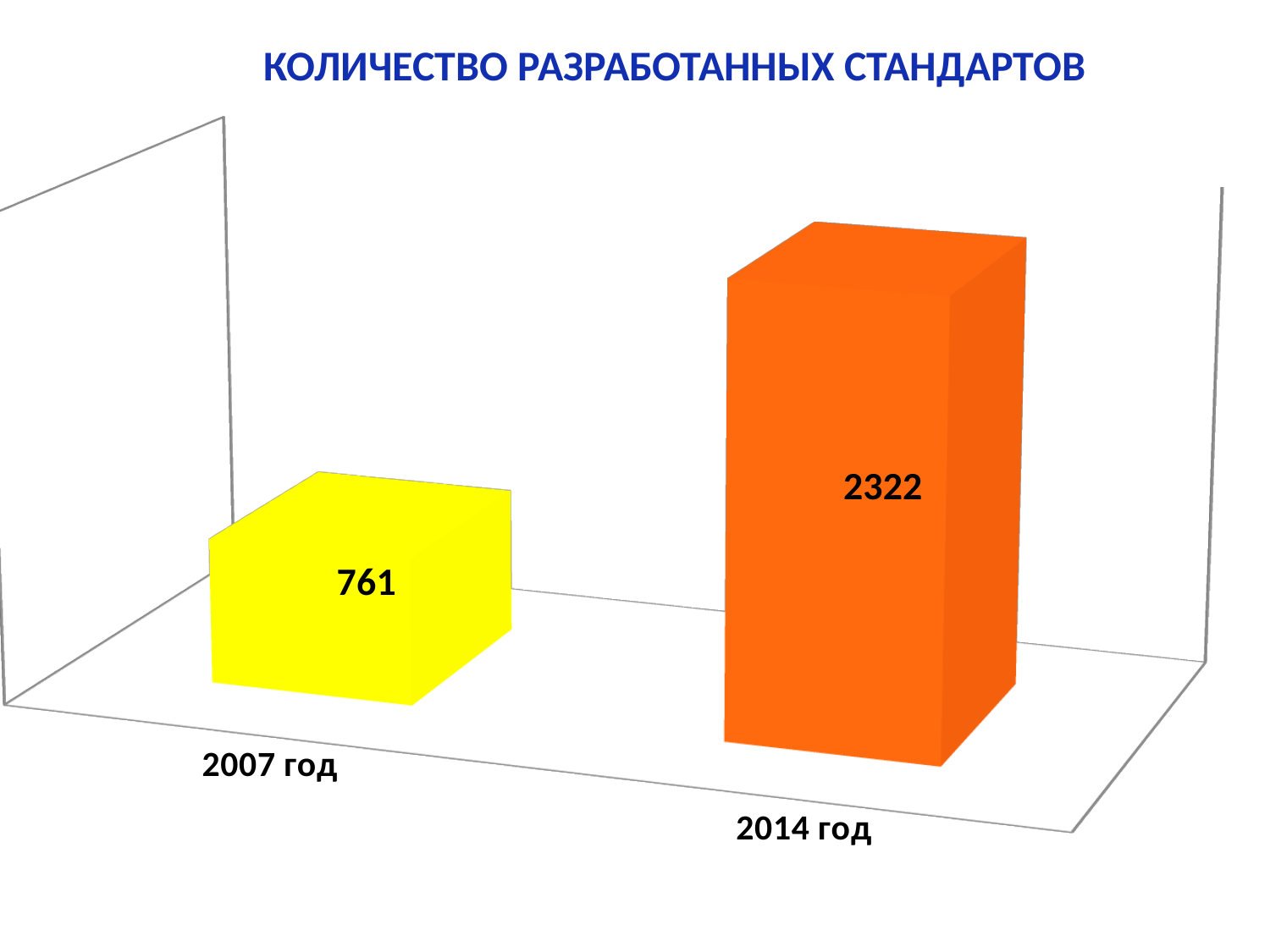
What is the value for 2007 год? 761 Do the values rise or fall from 2007 год to 2014 год? rise What is the difference between the values for 2014 год and 2007 год? 1561 Which category has the lowest value? 2007 год What is the title of the chart? КОЛИЧЕСТВО РАЗРАБОТАННЫХ СТАНДАРТОВ Which is larger, the value for 2007 год or the value for 2014 год? 2014 год What colour is the bar for 2014 год? orange What is the value for 2014 год? 2322 What kind of chart is shown on the slide? bar chart Which category has the highest value? 2014 год How many categories are shown in the chart? 2